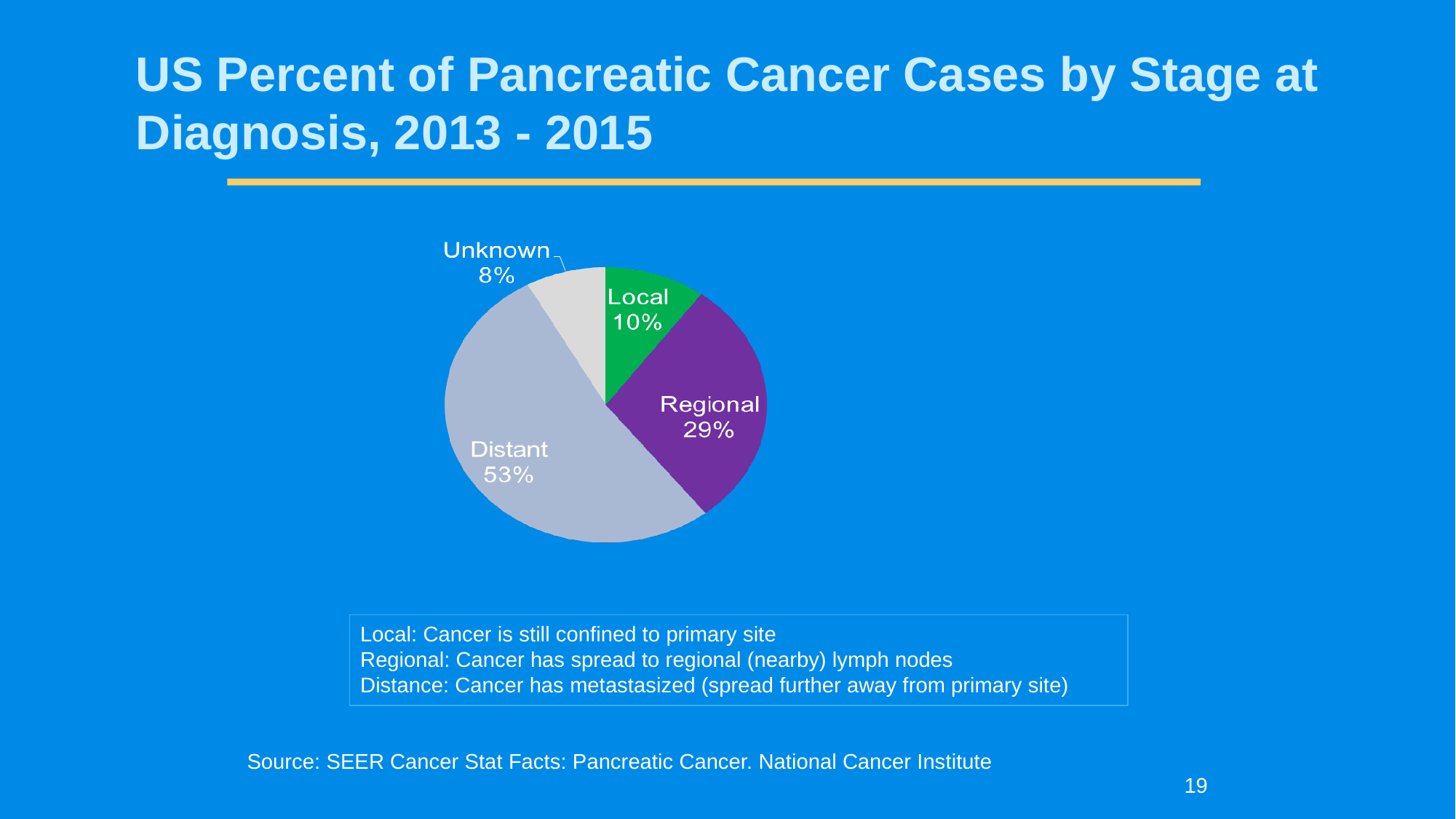
What percentage of cases have an Unknown stage at diagnosis? 8% Which is larger, the Local slice or the Unknown slice? Local What colour is the Regional slice of the pie chart? Purple What percentage of cases were diagnosed at the Regional stage? 29% What percentage of pancreatic cancer cases were diagnosed at the Distant stage? 53% Which stage accounts for the largest share of cases? Distant What is the difference in percentage points between the Distant and Regional slices? 24 What is the combined percentage of the Local and Regional slices? 39% What kind of chart is shown on the slide? Pie chart Which stage accounts for the smallest share of cases? Unknown How many slices does the pie chart have? 4 What percentage of cases were diagnosed at the Local stage? 10%